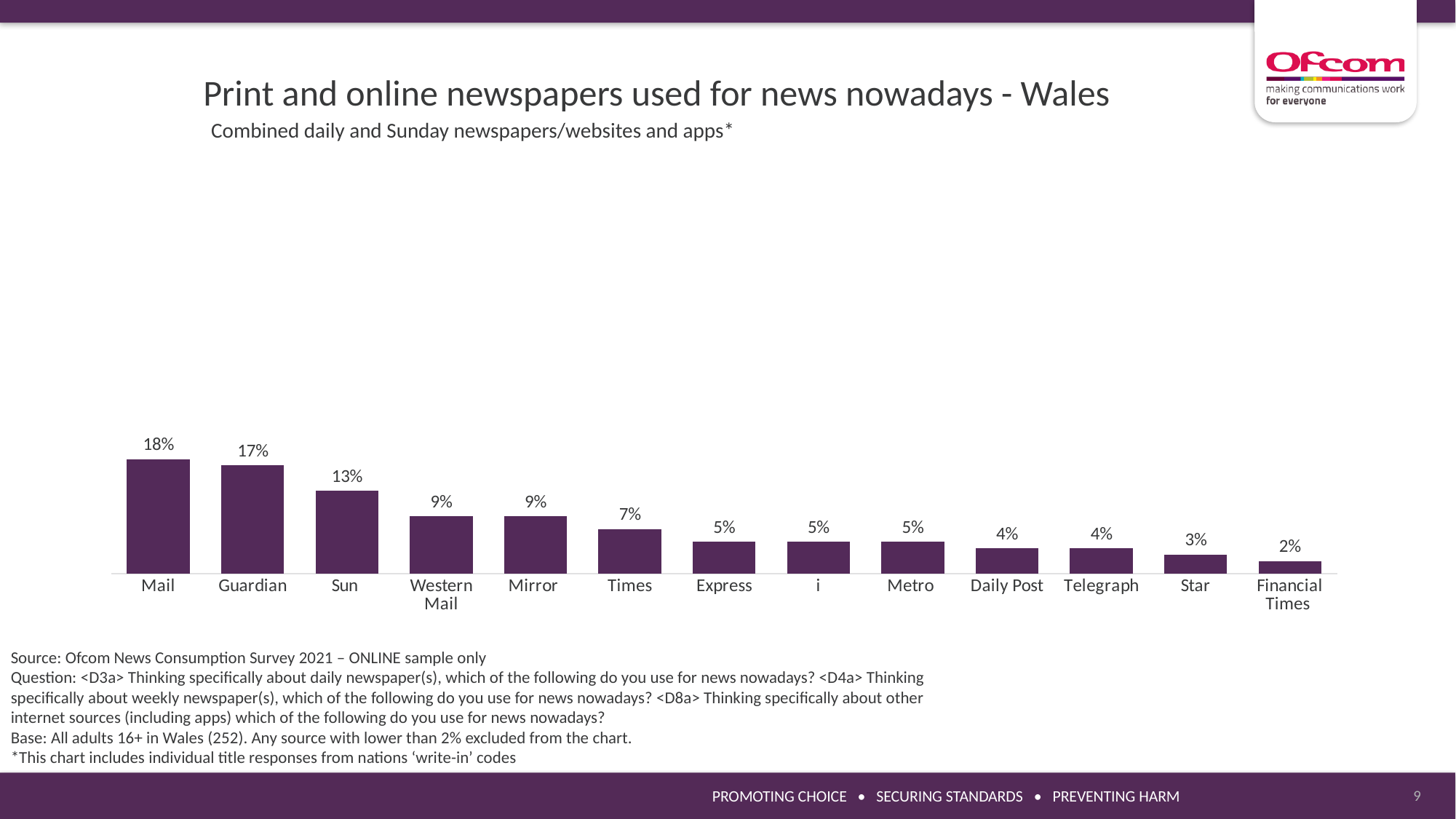
Which newspaper has the lowest value on the chart? Financial Times What is the difference between the values for the Mail and the Sun? 5% What is the value shown for the Daily Post? 4% What type of chart is shown on the slide? Bar chart Do the values rise or fall from left to right across the chart? Fall What is the difference between the values for the Guardian and the Times? 10% What percentage of adults in Wales use the Mail for news nowadays? 18% Which newspaper has the highest value on the chart? Mail What is the value shown for the Western Mail? 9% Which has a higher value, the Sun or the Mirror? Sun How many newspapers are shown on the chart? 13 Which has a higher value, the Telegraph or the Star? Telegraph